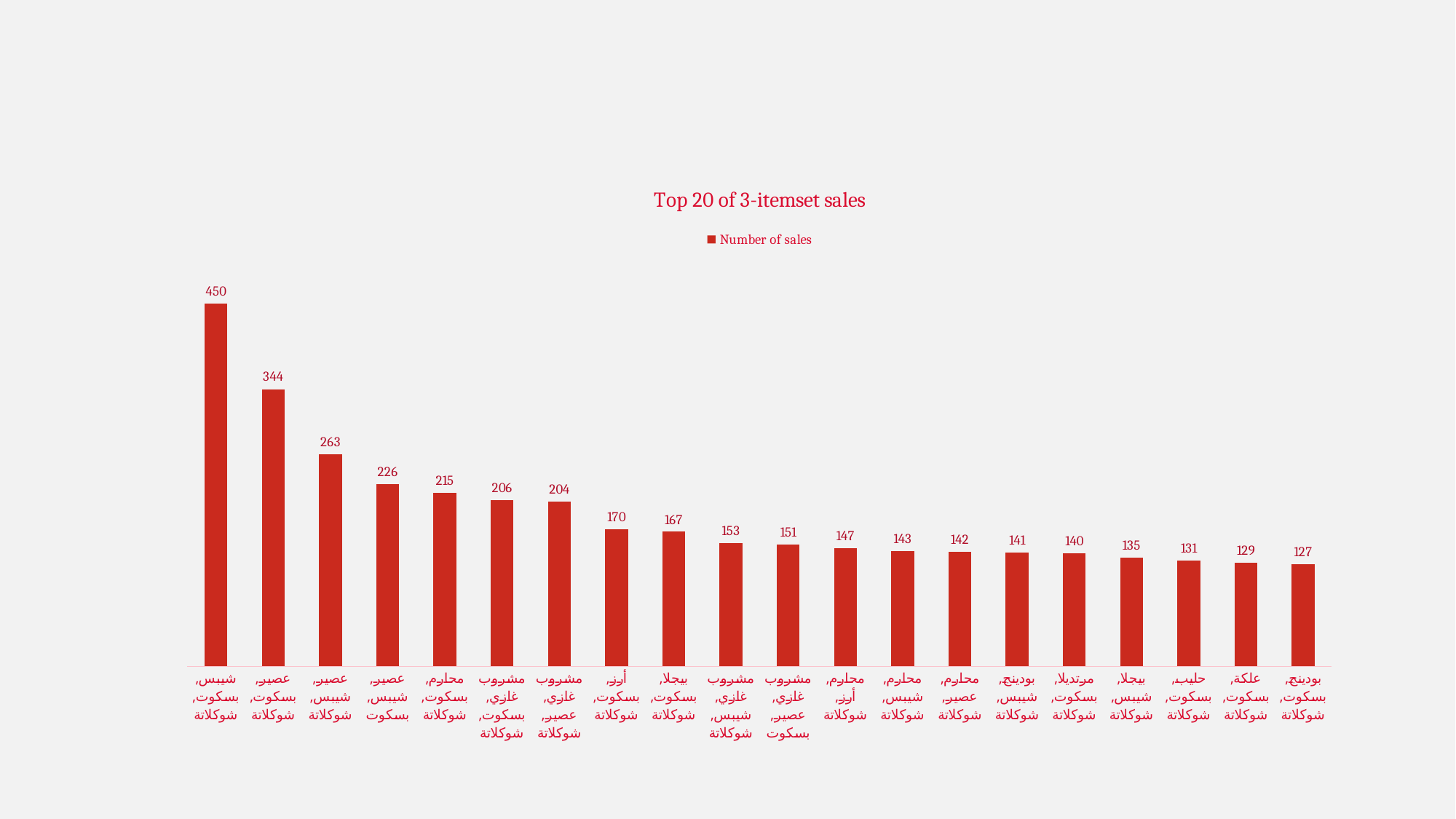
How many series does the legend list? 1 What is the number of sales for the itemset حليب, بسكوت, شوكلاتة? 131 What is the number of sales for the itemset شيبس, بسكوت, شوكلاتة? 450 What is the number of sales for the itemset عصير, بسكوت, شوكلاتة? 344 What is the title of the chart? Top 20 of 3-itemset sales Which itemset has the lowest number of sales? بودينج, بسكوت, شوكلاتة What is the difference in number of sales between شيبس, بسكوت, شوكلاتة and عصير, بسكوت, شوكلاتة? 106 Which has more sales: عصير, شيبس, شوكلاتة or عصير, شيبس, بسكوت? عصير, شيبس, شوكلاتة What type of chart is shown on the slide? Bar chart Which itemset has the highest number of sales? شيبس, بسكوت, شوكلاتة Do the values rise or fall from left to right along the x axis? Fall How many itemsets are shown in the chart? 20